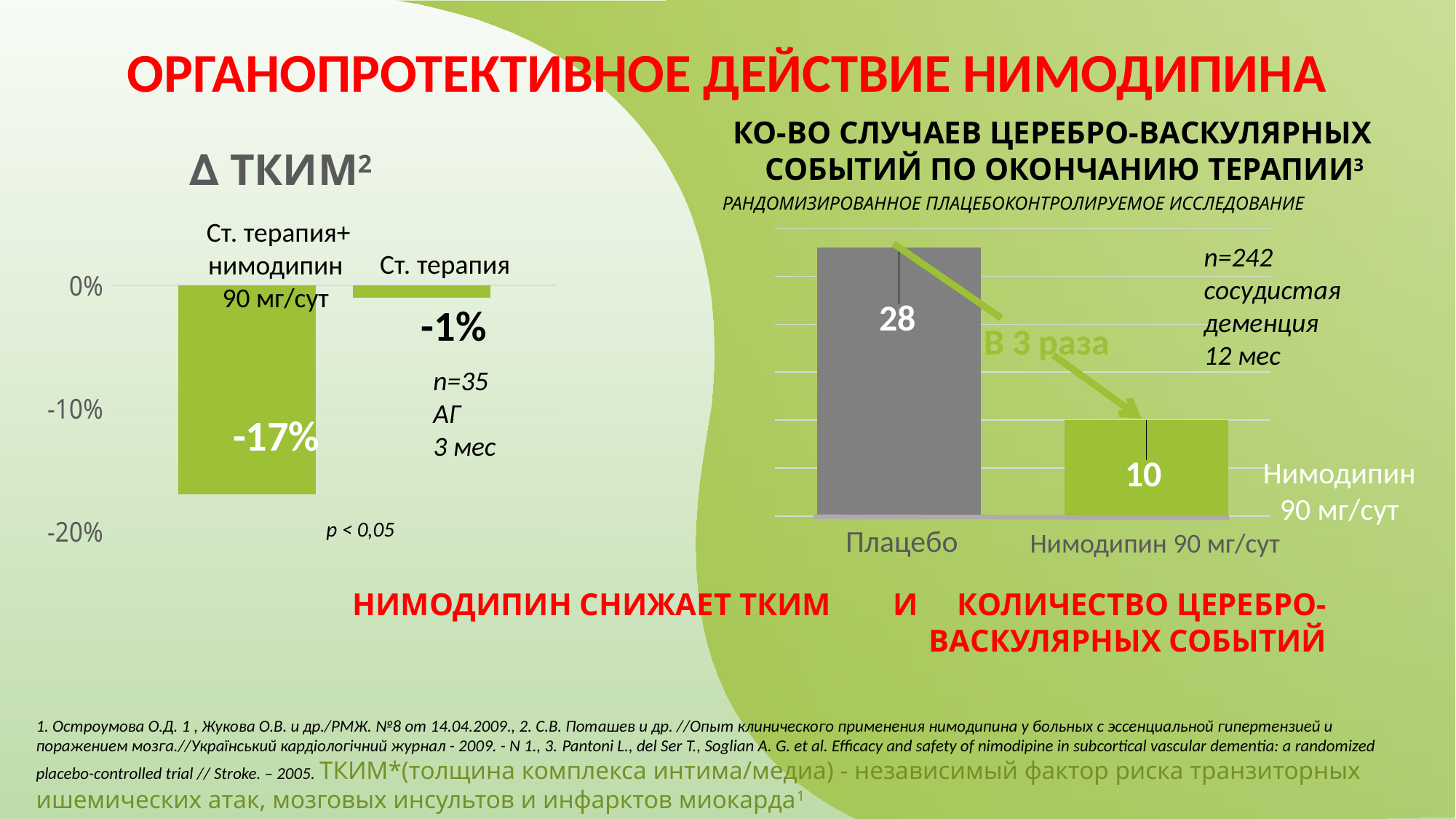
In the chart of cerebrovascular events, what is the difference between the Плацебо and Нимодипин 90 мг/сут values? 18 What type of chart is the Δ ТКИМ chart? Bar chart In the chart of cerebrovascular events, what colour is the Плацебо bar? Grey In the chart of cerebrovascular events, which category has the highest value? Плацебо In the Δ ТКИМ chart, what is the value for Ст. терапия? -1% In the Δ ТКИМ chart, how many bars are plotted? 2 In the chart of cerebrovascular events, how many categories are plotted? 2 In the Δ ТКИМ chart, which category shows the larger reduction in ТКИМ? Ст. терапия+ нимодипин 90 мг/сут In the chart of cerebrovascular events (Ко-во случаев церебро-васкулярных событий), what is the value for Плацебо? 28 In the Δ ТКИМ chart, what is the value for Ст. терапия+ нимодипин 90 мг/сут? -17% In the Δ ТКИМ chart, what is the difference in percentage points between the Ст. терапия+ нимодипин 90 мг/сут bar and the Ст. терапия bar? 16 percentage points In the chart of cerebrovascular events (Ко-во случаев церебро-васкулярных событий), what is the value for Нимодипин 90 мг/сут? 10